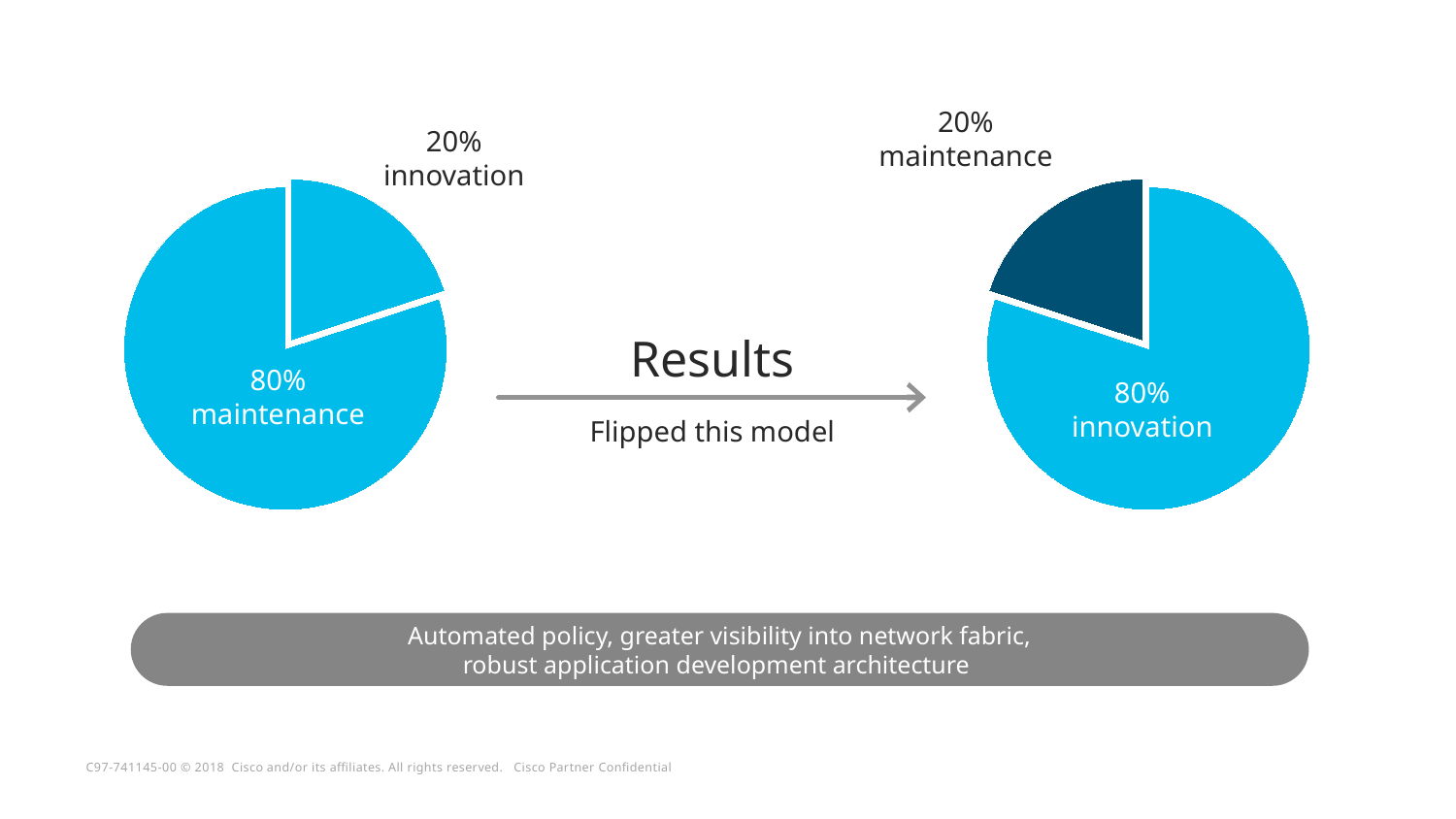
How many slices does the right pie chart have? 2 In the right pie chart, which slice is the smallest? maintenance In the left pie chart, which slice is the largest? maintenance In the right pie chart, is the innovation slice larger or smaller than the maintenance slice? larger How many pie charts are on the slide? 2 In the right pie chart, what share is labelled for maintenance? 20% In the left pie chart, what is the difference between the maintenance share and the innovation share? 60% In the left pie chart, what share is labelled for innovation? 20% In the left pie chart, what share is labelled for maintenance? 80% What text appears above the arrow between the two pie charts? Results In the right pie chart, what share is labelled for innovation? 80% What kind of chart is shown on the left of the slide? pie chart